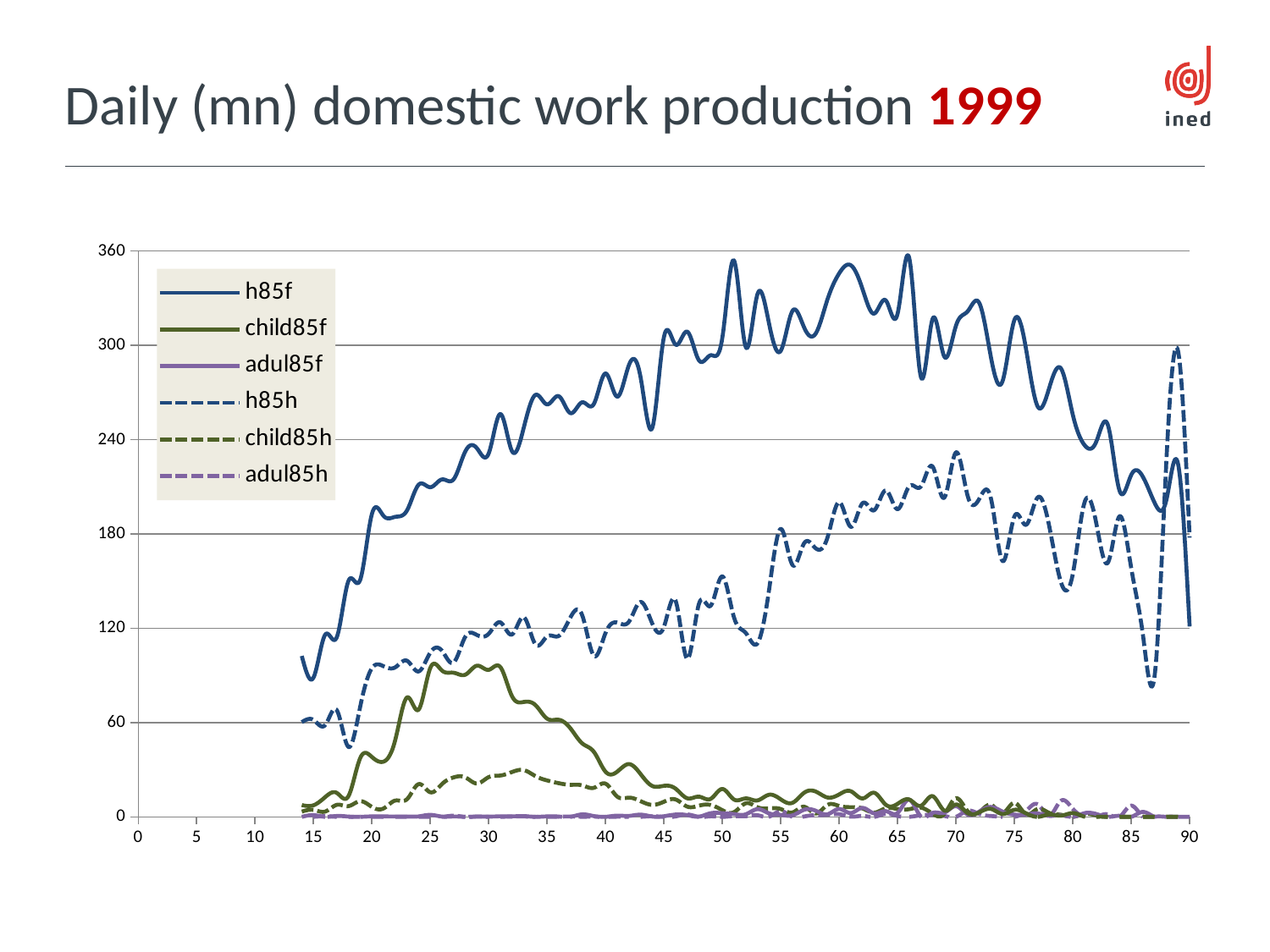
How many series does the legend list? 6 What kind of chart is shown on the slide? line chart What is the title of the chart? Daily (mn) domestic work production 1999 At x = 50, which series has the larger value, h85f or h85h? h85f Which series reaches the highest values on the chart? h85f Does the child85f series rise or fall between x = 30 and x = 50? fall Is the value for h85f at x = 60 greater or less than 300? greater Is the value for child85f at x = 25 greater or less than 60? greater Which series are drawn with dashed lines? h85h, child85h, adul85h Is the value for h85h at x = 30 greater or less than 180? less Does the h85f series rise or fall between x = 15 and x = 50? rise